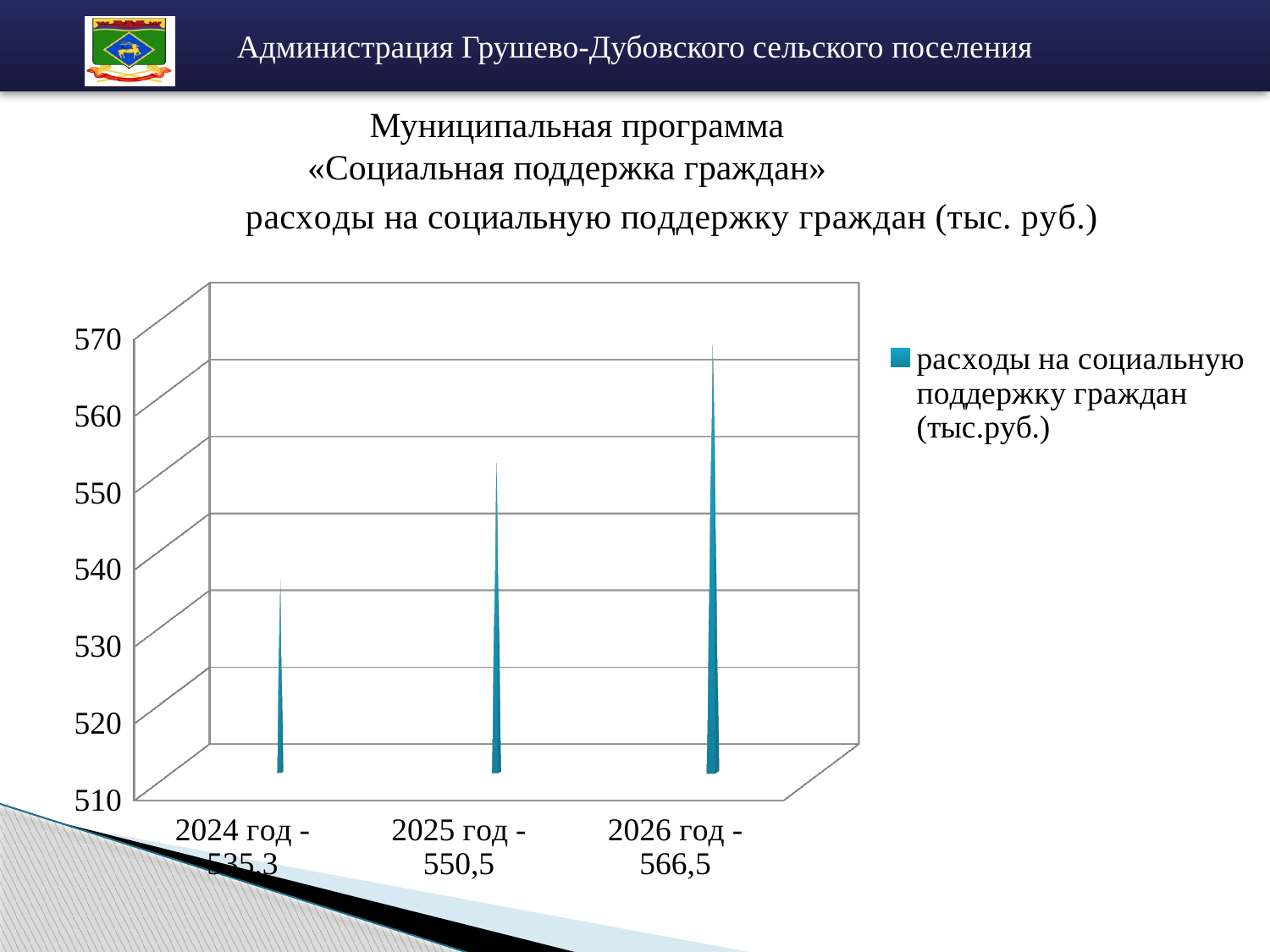
How many years are shown on the chart? 3 What is the value for 2024 год? 535,3 Do the values rise or fall from 2024 to 2026? rise What is the value for 2026 год? 566,5 Is the value for 2026 год greater or less than 560? greater Which is larger, the value for 2025 год or the value for 2024 год? 2025 год What is the difference between the values for 2026 год and 2025 год? 16 What is the difference between the values for 2025 год and 2024 год? 15,2 How many series does the legend list? 1 Which year has the highest expenditure on social support? 2026 год Which year has the lowest expenditure on social support? 2024 год What is the value for 2025 год? 550,5